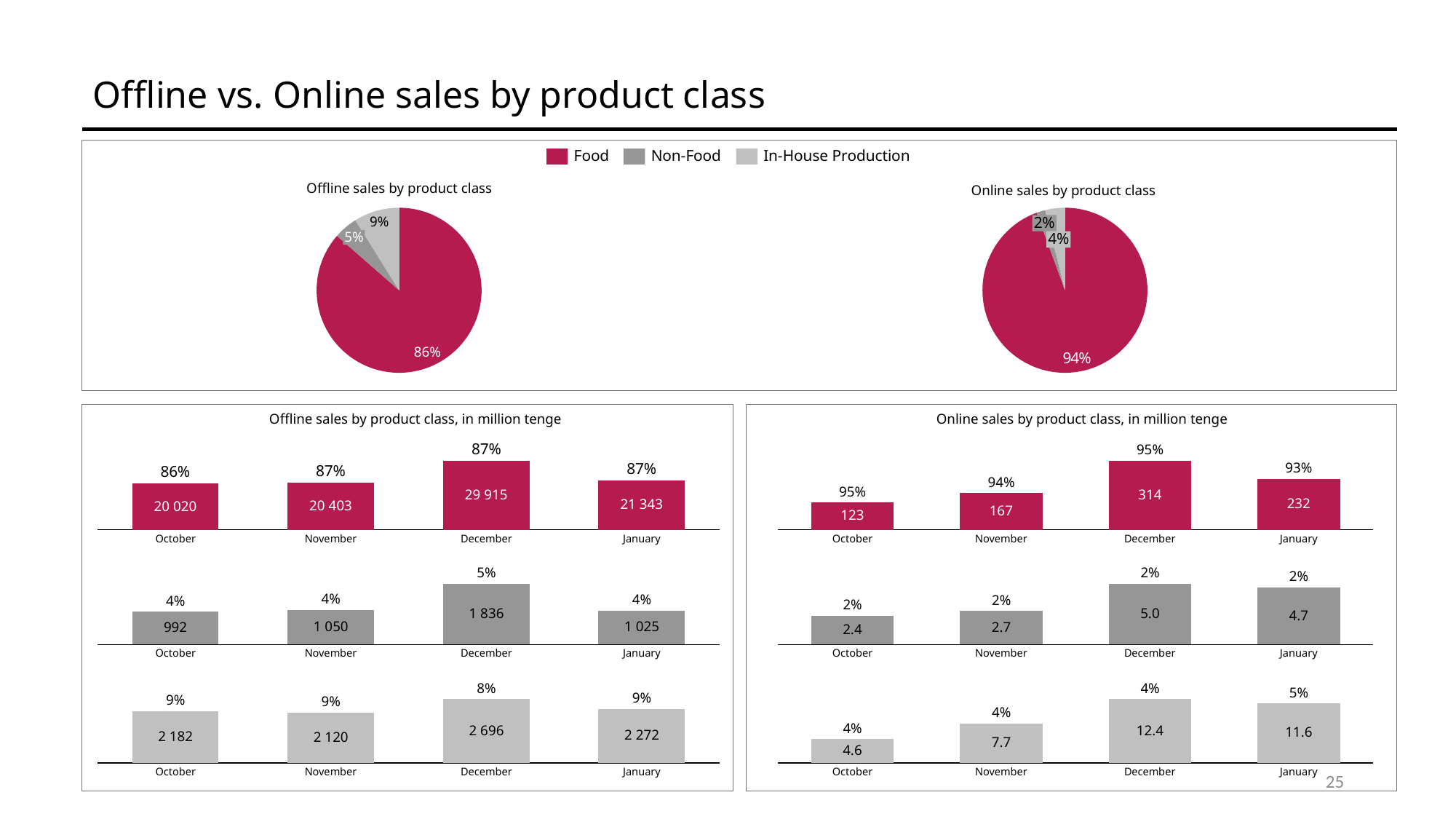
In the 'Online sales by product class, in million tenge' chart, what is the difference between the In-House Production values for December and October? 7.8 In the 'Online sales by product class, in million tenge' chart, which is larger: the Non-Food value for December or for January? December In the 'Offline sales by product class, in million tenge' chart, which month has the highest Non-Food value? December In the 'Offline sales by product class' pie chart, what share does Food have? 86% How many series does the legend at the top of the slide list? 3 What kind of chart is 'Online sales by product class' at the top right of the slide? Pie chart In the 'Offline sales by product class, in million tenge' chart, what is the Food value for December? 29 915 In the 'Offline sales by product class, in million tenge' chart, what is the difference between the Food values for December and January? 8 572 In the 'Online sales by product class, in million tenge' chart, which month has the lowest Food value? October In the 'Online sales by product class' pie chart, what share does Non-Food have? 2% How many months are shown on the x axis of the 'Offline sales by product class, in million tenge' chart? 4 In the 'Online sales by product class, in million tenge' chart, what is the In-House Production value for November? 7.7